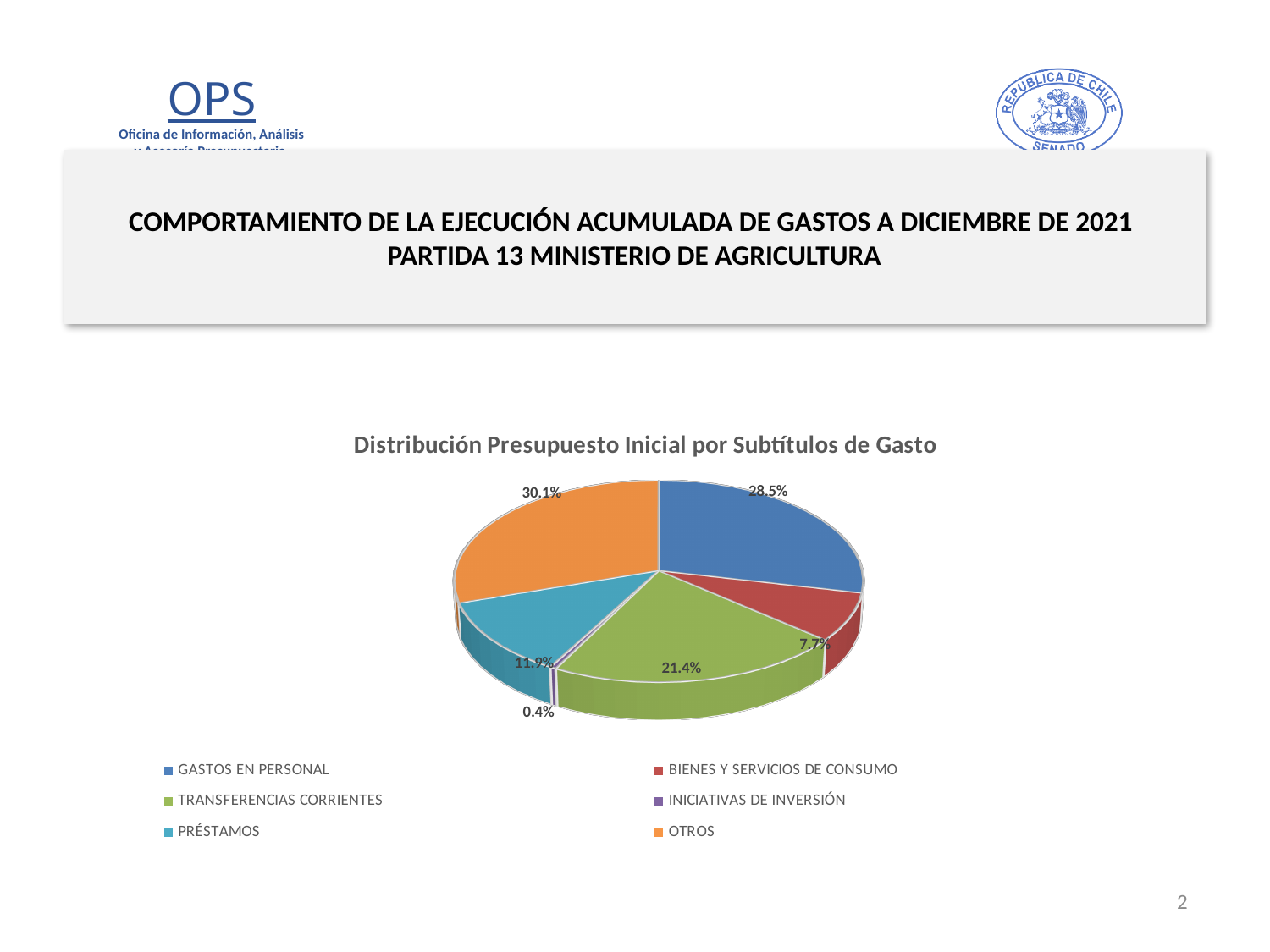
What is the title of the chart? Distribución Presupuesto Inicial por Subtítulos de Gasto What is the difference between the shares of OTROS and GASTOS EN PERSONAL? 1.6% What share of the pie does BIENES Y SERVICIOS DE CONSUMO represent? 7.7% What share of the pie does PRÉSTAMOS represent? 11.9% What share of the pie does OTROS represent? 30.1% How many categories does the legend list? 6 What kind of chart is shown on the slide? Pie chart Which is larger, the share of TRANSFERENCIAS CORRIENTES or the share of PRÉSTAMOS? TRANSFERENCIAS CORRIENTES Which category has the largest share of the pie? OTROS Which category has the smallest share of the pie? INICIATIVAS DE INVERSIÓN